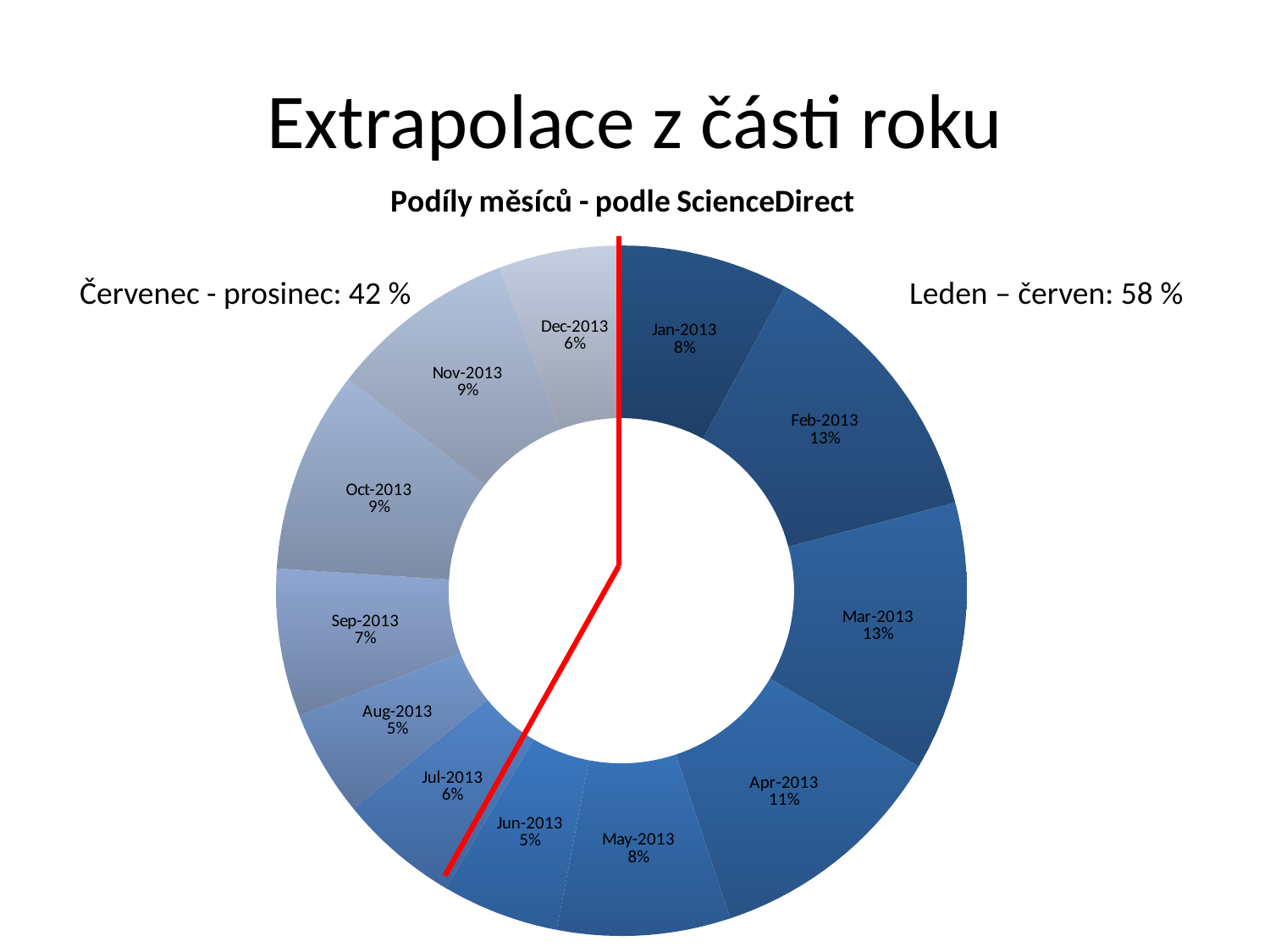
What is the difference in percentage points between Apr-2013 and Aug-2013? 6 What is the title of the chart? Podíly měsíců - podle ScienceDirect What is the value for Dec-2013? 6% What is the value for Jun-2013? 5% What is the difference in percentage points between Mar-2013 and Jun-2013? 8 What is the value shown for Apr-2013? 11% How many months (slices) are shown in the chart? 12 What share of the doughnut chart does Feb-2013 represent? 13% Which is larger, the share for Mar-2013 or the share for Sep-2013? Mar-2013 What kind of chart is shown on the slide? doughnut chart Which is larger, the share for Aug-2013 or the share for Nov-2013? Nov-2013 What percentage is shown for Oct-2013? 9%